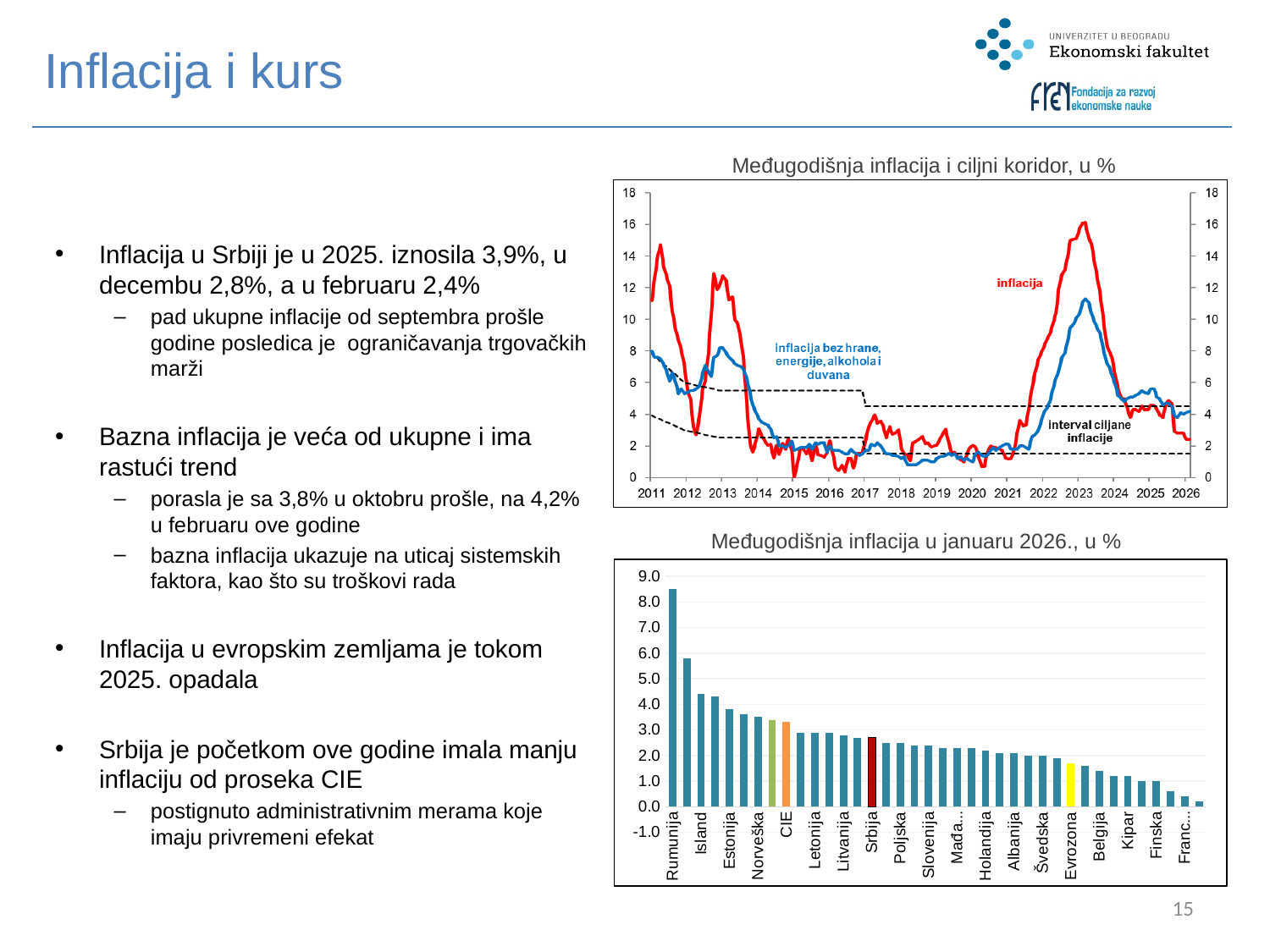
On the bottom chart 'Međugodišnja inflacija u januaru 2026., u %', is the value for Srbija greater or less than 3.0? less On the bottom chart 'Međugodišnja inflacija u januaru 2026., u %', do the values rise or fall from left to right? fall On the bottom chart 'Međugodišnja inflacija u januaru 2026., u %', which is larger, the value for Srbija or the value for CIE? CIE On the bottom chart 'Međugodišnja inflacija u januaru 2026., u %', which is larger, the value for Srbija or the value for Evrozona? Srbija On the bottom chart 'Međugodišnja inflacija u januaru 2026., u %', what colour is the bar for Srbija? red On the bottom chart 'Međugodišnja inflacija u januaru 2026., u %', which country has the highest inflation? Rumunija What kind of chart is the bottom chart 'Međugodišnja inflacija u januaru 2026., u %'? bar chart On the top chart 'Međugodišnja inflacija i ciljni koridor, u %', is the peak value of the 'inflacija' series in 2023 greater or less than 14? greater On the bottom chart 'Međugodišnja inflacija u januaru 2026., u %', is the value for Island greater or less than 5.0? less What kind of chart is the top chart 'Međugodišnja inflacija i ciljni koridor, u %'? line chart